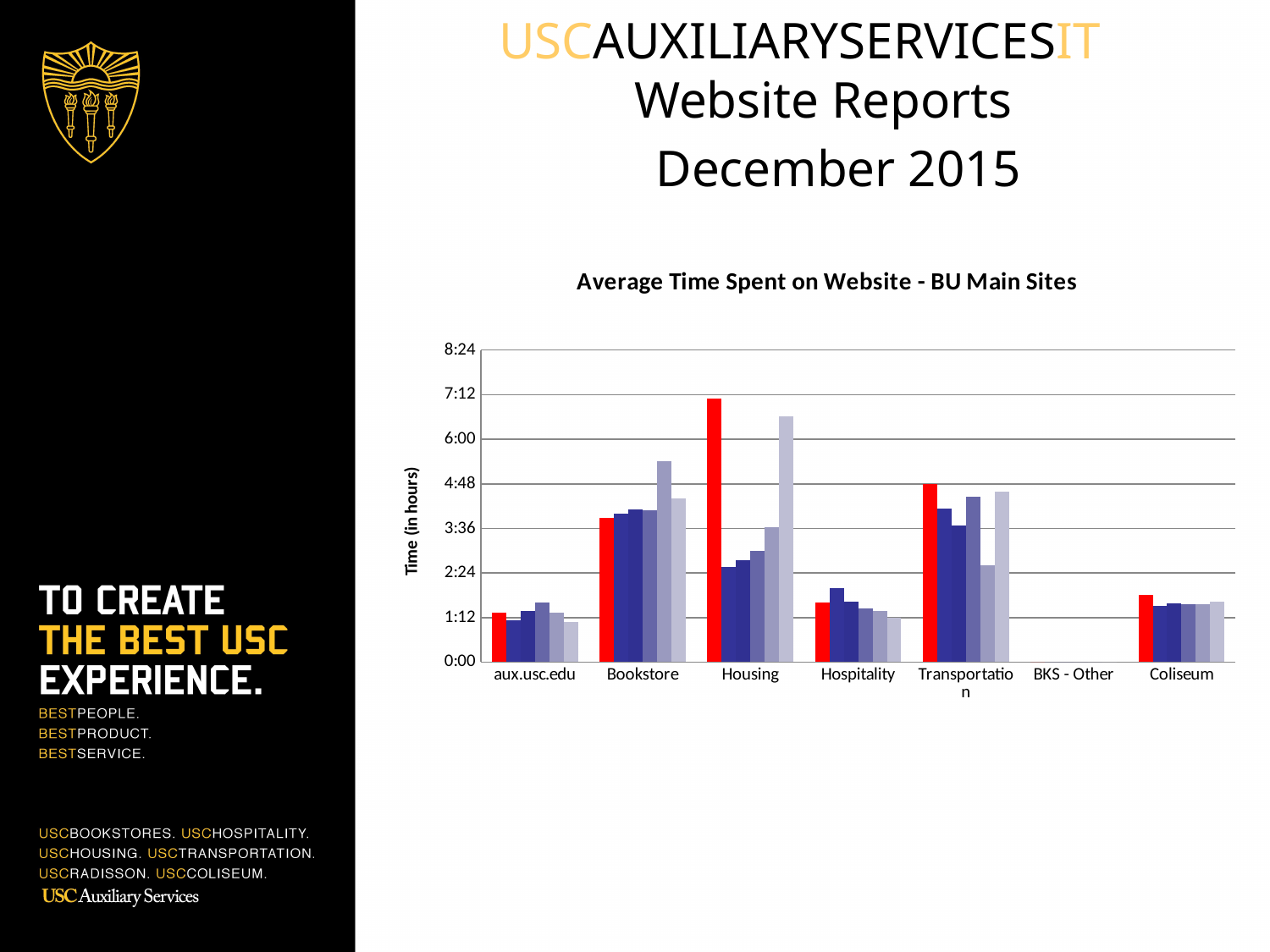
Which category has the tallest red bar? Housing Is the value of the red bar for Hospitality greater or less than 1:12? greater Is the value of the red bar for Housing greater or less than 6:00? greater Is the value of the red bar for Coliseum greater or less than 2:24? less Which has the larger red bar, Bookstore or Coliseum? Bookstore What kind of chart is shown on the slide? bar chart What is the title of the chart? Average Time Spent on Website - BU Main Sites Which has the larger red bar, Housing or Bookstore? Housing How many categories are shown along the x axis of the chart? 7 What is the label on the vertical axis of the chart? Time (in hours) Which category shows no bars at all? BKS - Other How many bars are plotted for the Housing category? 6